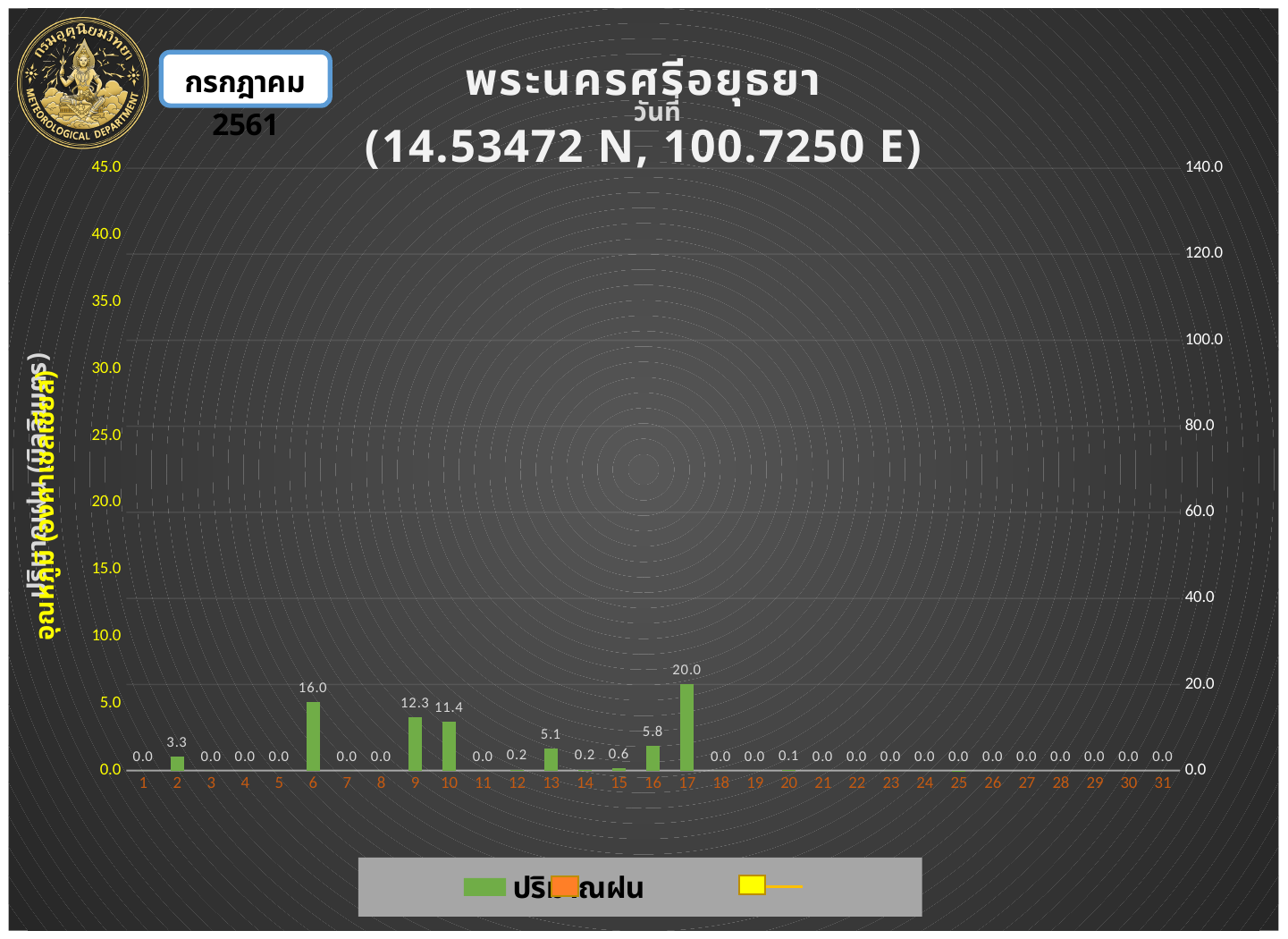
What is the difference between the rainfall values for day 9 and day 10? 0.9 How many days are shown on the x axis? 31 What kind of chart is shown on the slide? bar chart Which day has the highest rainfall value? 17 What coordinates are given in the chart title? 14.53472 N, 100.7250 E What is the difference between the rainfall values for day 17 and day 6? 4.0 Which is larger, the rainfall value for day 13 or for day 16? day 16 What is the rainfall value shown for day 20? 0.1 What is the rainfall value shown for day 6? 16.0 What is the rainfall value shown for day 9? 12.3 What is the rainfall value shown for day 17? 20.0 What is the rainfall value shown for day 2? 3.3